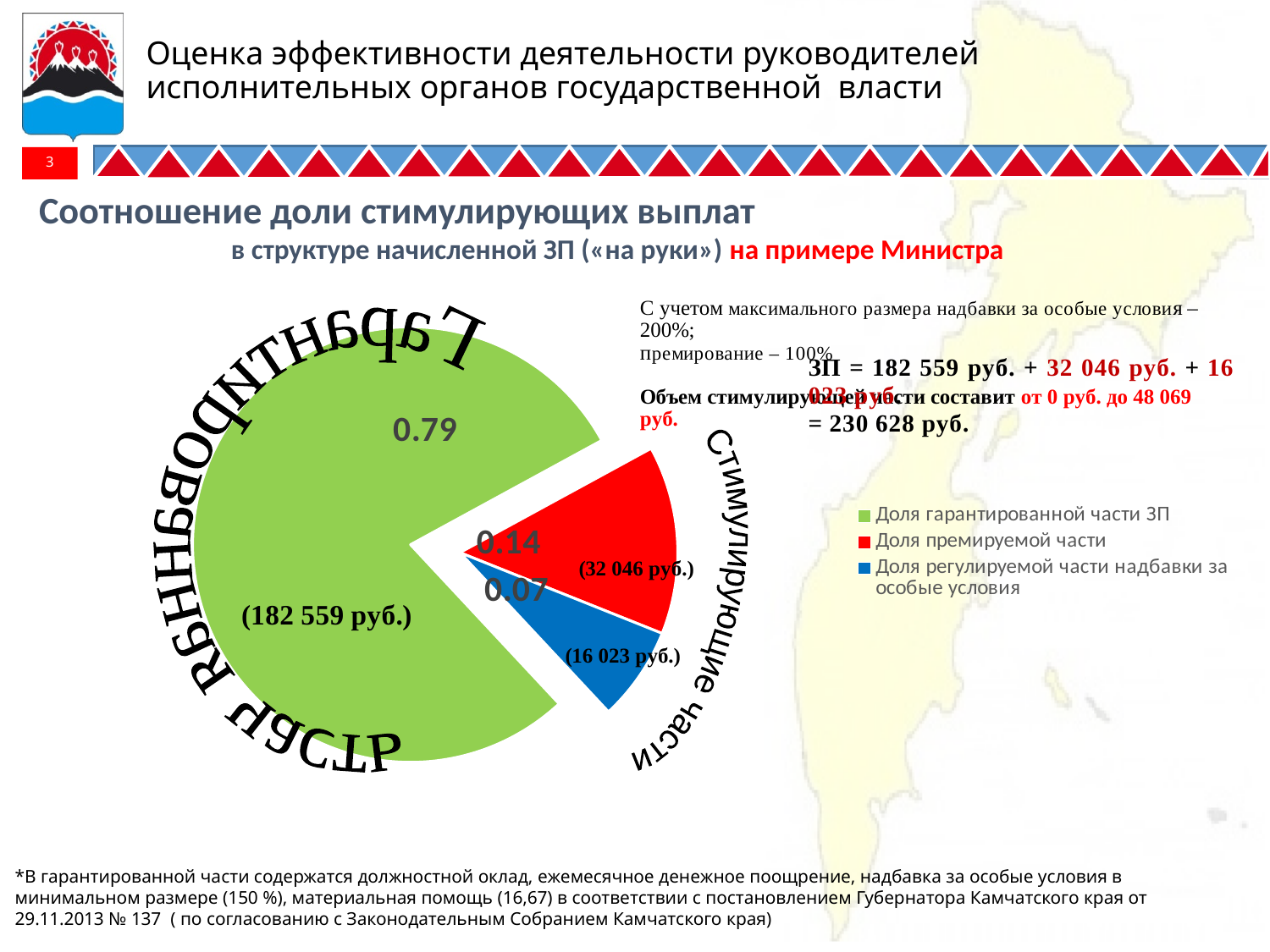
What ruble amount is labelled on the red slice of the pie chart? 32 046 руб. Which slice of the pie chart is the largest? Доля гарантированной части ЗП What is the value of the slice for 'Доля гарантированной части ЗП'? 0.79 What is the value of the slice for 'Доля премируемой части'? 0.14 What is the value of the slice for 'Доля регулируемой части надбавки за особые условия'? 0.07 How many series does the legend list? 3 What colour is the slice for 'Доля гарантированной части ЗП'? green How many slices does the pie chart have? 3 Which is larger: the slice for 'Доля премируемой части' or the slice for 'Доля регулируемой части надбавки за особые условия'? Доля премируемой части What is the difference between the values for 'Доля премируемой части' and 'Доля регулируемой части надбавки за особые условия'? 0.07 What kind of chart is shown on the slide? pie chart Which slice of the pie chart is the smallest? Доля регулируемой части надбавки за особые условия